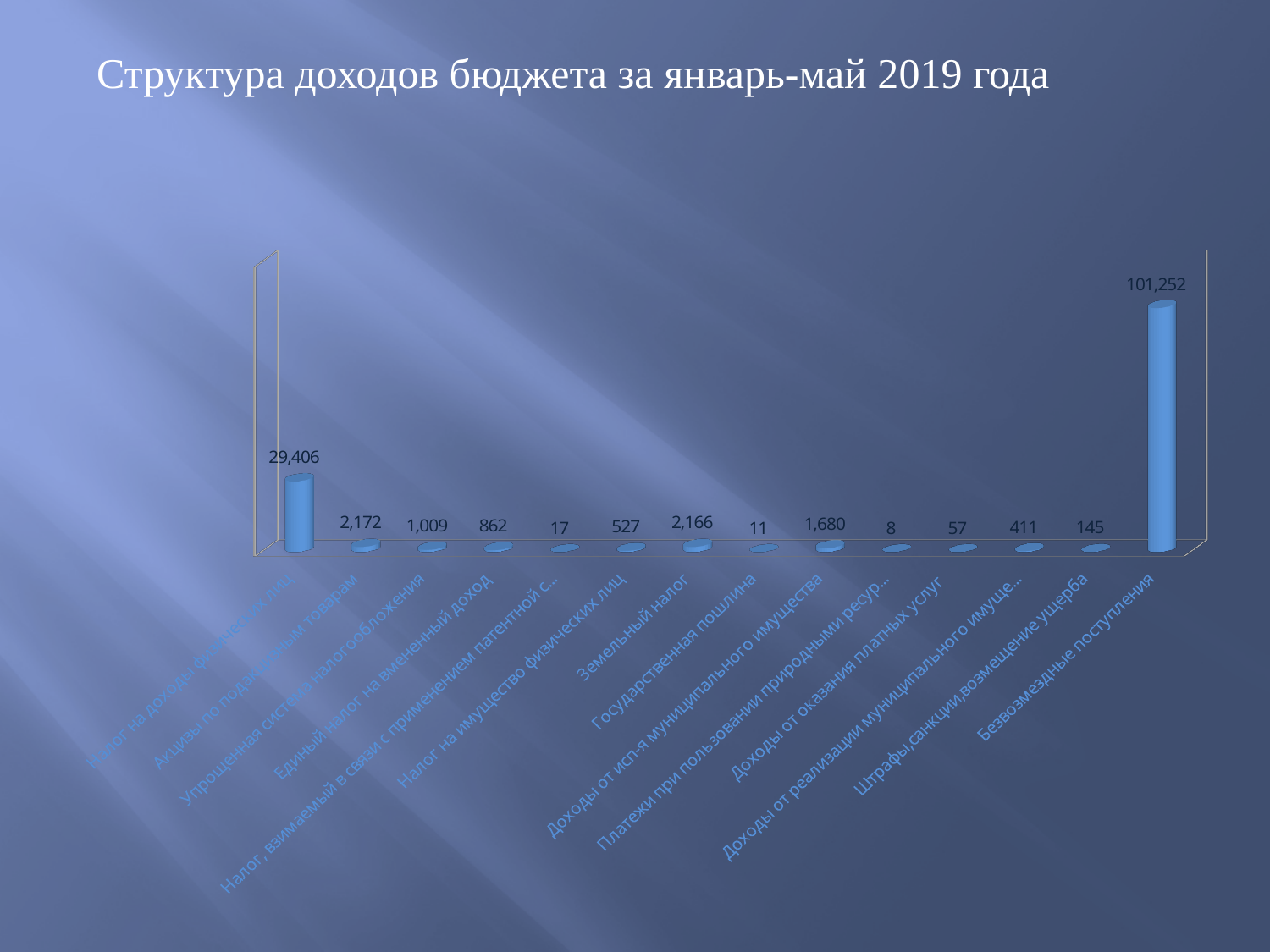
What is the value for Безвозмездные поступления? 101,252 What is the value for Государственная пошлина? 11 What is the value for Доходы от оказания платных услуг? 57 What is the title of the slide? Структура доходов бюджета за январь-май 2019 года Which is larger: the value for Акцизы по подакцизным товарам or the value for Упрощенная система налогообложения? Акцизы по подакцизным товарам What is the value for Штрафы,санкции,возмещение ущерба? 145 Which category has the highest value? Безвозмездные поступления What is the value for Земельный налог? 2,166 How many categories are shown in the chart? 14 What is the difference between the values for Безвозмездные поступления and Налог на доходы физических лиц? 71,846 What is the difference between the values for Земельный налог and Налог на имущество физических лиц? 1,639 What kind of chart is shown on the slide? Bar chart